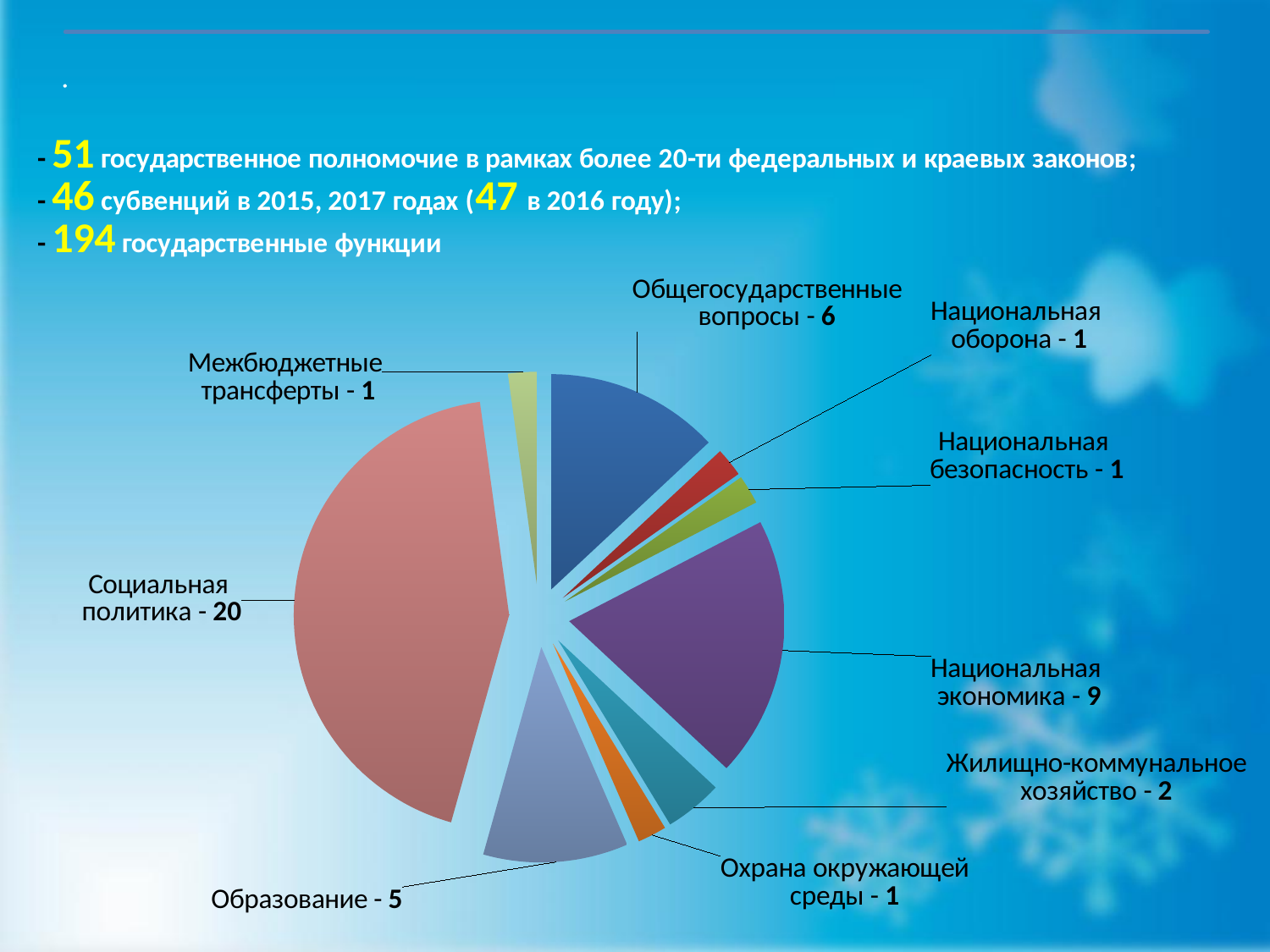
How many categories in the pie chart have a value of 1? 4 Which category has the largest slice of the pie? Социальная политика What is the value for Общегосударственные вопросы? 6 What is the total of all the values shown in the pie chart? 46 How many categories (slices) does the pie chart have? 9 What is the value for Жилищно-коммунальное хозяйство? 2 What is the value for Национальная экономика? 9 What is the value for Социальная политика? 20 What kind of chart is shown on the slide? pie chart Which is larger, the value for Образование or the value for Жилищно-коммунальное хозяйство? Образование What is the difference between the values for Социальная политика and Национальная экономика? 11 What is the difference between the values for Общегосударственные вопросы and Образование? 1